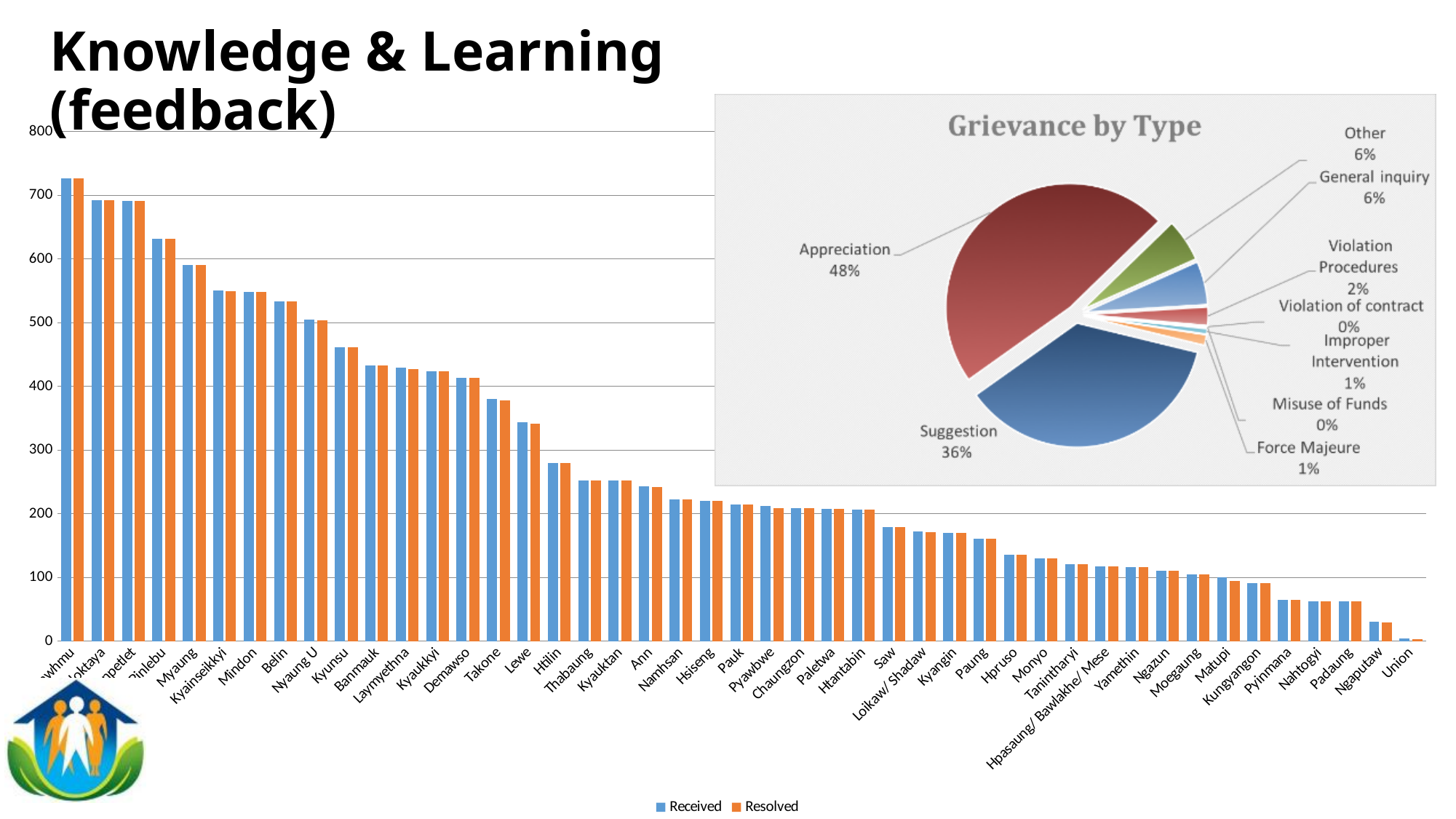
In the Grievance by Type pie chart, what share is Suggestion? 36% What kind of chart is the Grievance by Type chart? Pie chart In the bar chart on the left, do the Received values rise or fall from left to right along the x axis? fall In the Grievance by Type pie chart, which type has the largest share? Appreciation In the bar chart on the left, is the Received value for Myaung greater or less than 500? greater In the bar chart on the left, which category has the lowest Received value? Union In the bar chart on the left, is the Received value for Saw greater or less than 200? less In the Grievance by Type pie chart, how many percentage points larger is Appreciation than Suggestion? 12% In the Grievance by Type pie chart, what share is Appreciation? 48% What kind of chart is the chart on the left with the Received and Resolved series? Bar chart In the bar chart on the left, how many series does the legend list? 2 In the Grievance by Type pie chart, what share is Force Majeure? 1%